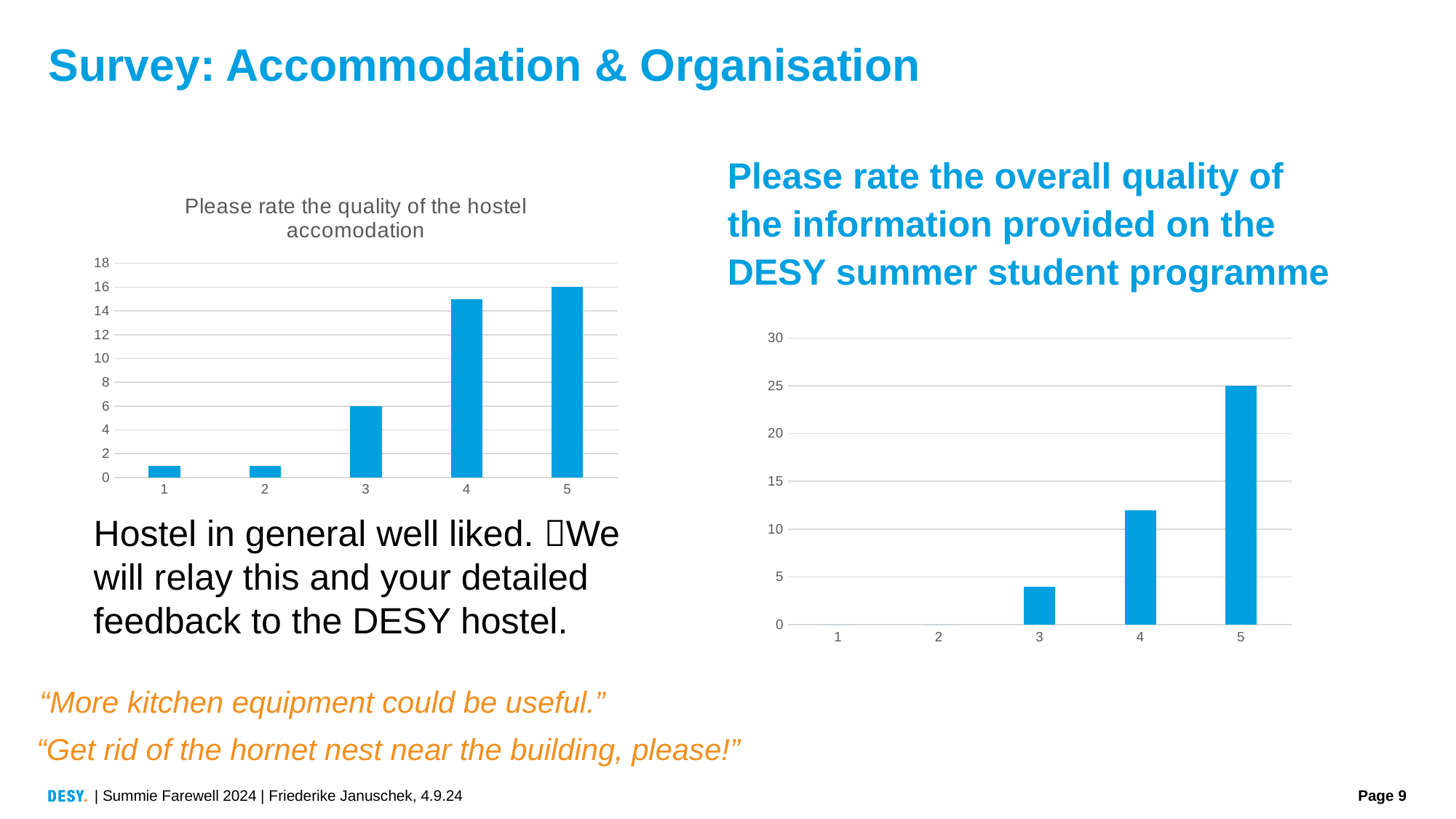
On the right chart (quality of information), do the values rise or fall from rating 3 to rating 5? rise On the left chart (hostel accommodation), which is larger, the value for rating 3 or rating 4? rating 4 On the left chart (hostel accommodation), what is the value for rating 5? 16 On the right chart (quality of information), is the value for rating 3 greater or less than 5? less On the right chart (quality of information), which rating has the highest value? 5 On the left chart (hostel accommodation), is the value for rating 1 greater or less than 2? less On the left chart (hostel accommodation), what kind of chart is it? bar chart On the left chart (hostel accommodation), what is the value for rating 3? 6 On the right chart (quality of information), is the value for rating 4 greater or less than 10? greater On the right chart (quality of information), what is the value for rating 5? 25 On the left chart (hostel accommodation), how many rating categories are shown on the x axis? 5